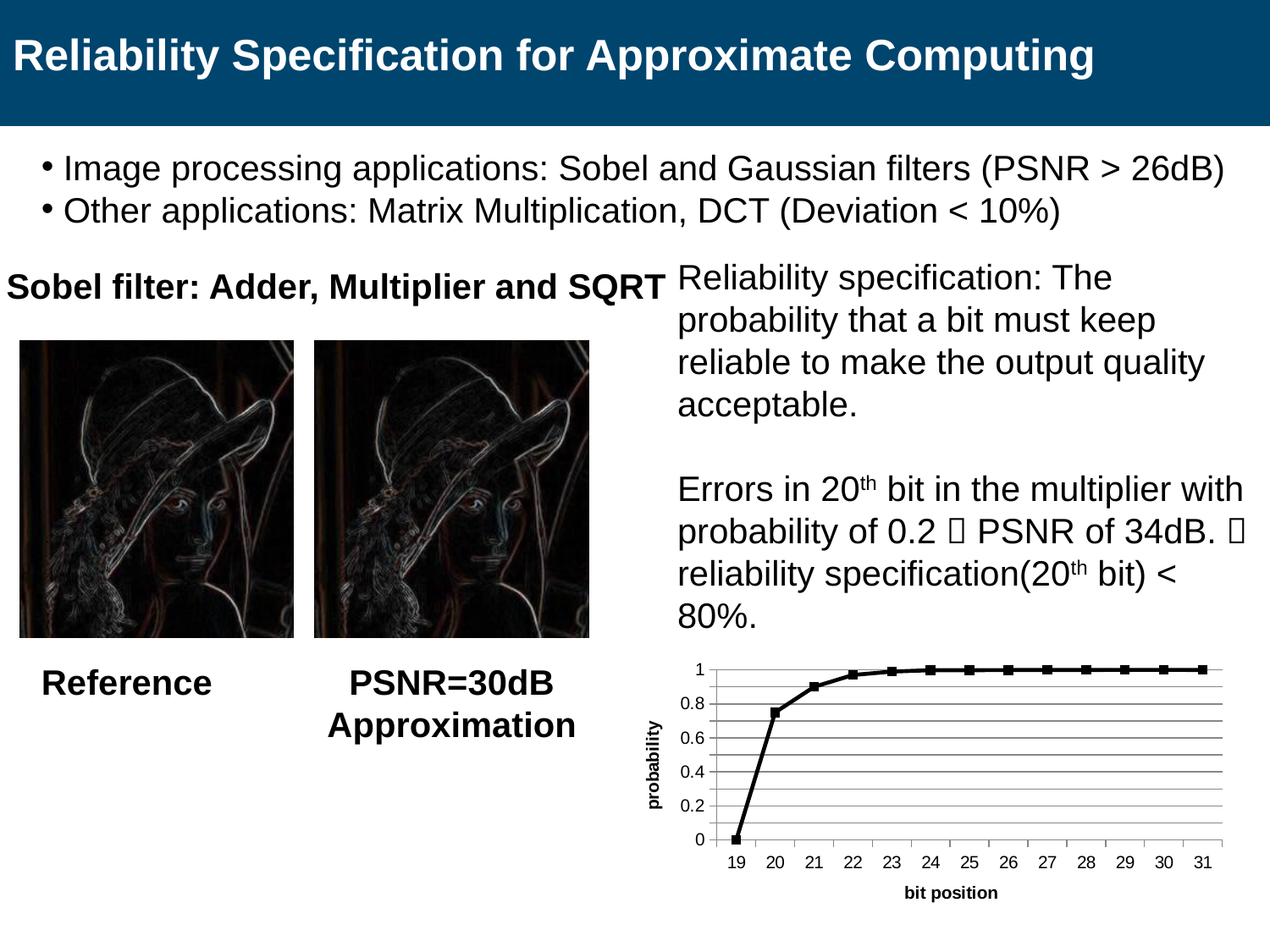
Is the probability for bit position 20 greater or less than 0.8? less Do the probability values rise or fall as the bit position increases from 19 to 31? rise How many bit positions are plotted on the x axis of the chart? 13 What kind of chart is shown on the slide? line chart What is the label of the x axis of the chart? bit position Is the probability for bit position 22 greater or less than 0.8? greater Is the probability for bit position 21 greater or less than 0.8? greater Which bit position has the lowest probability in the chart? 19 What is the label of the y axis of the chart? probability Which has the larger probability in the chart, bit position 20 or bit position 21? bit position 21 What is the probability value plotted for bit position 19? 0